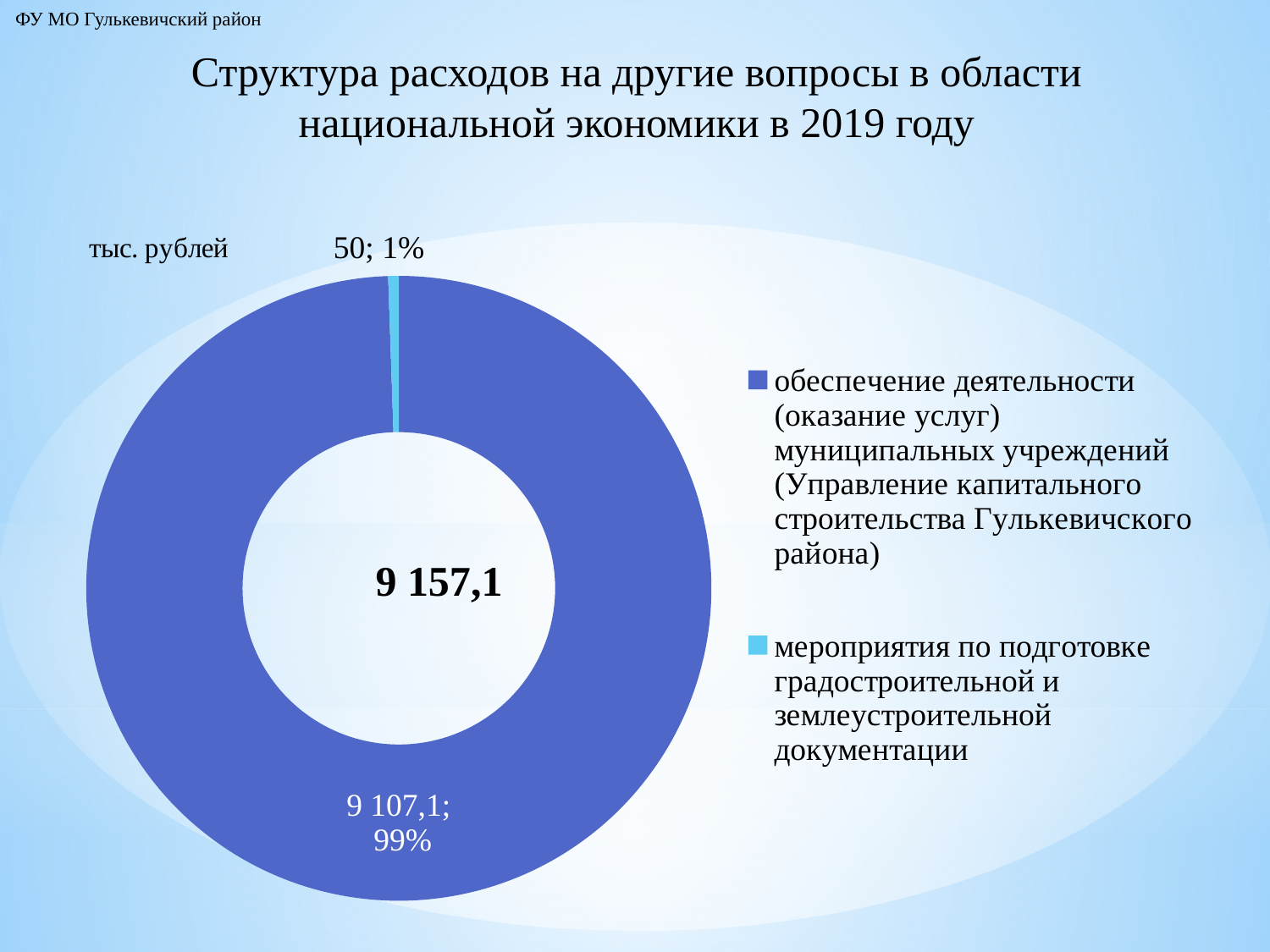
What colour is the slice for "мероприятия по подготовке градостроительной и землеустроительной документации"? light blue In what units are the chart values given? тыс. рублей What is the value for "мероприятия по подготовке градостроительной и землеустроительной документации"? 50 What is the difference between the values for "обеспечение деятельности" and "мероприятия по подготовке градостроительной и землеустроительной документации"? 9 057,1 What share of the chart does "обеспечение деятельности (оказание услуг) муниципальных учреждений" represent? 99% What total value is shown in the centre of the chart? 9 157,1 What type of chart is shown on the slide? doughnut (pie) chart Which category has the largest value? обеспечение деятельности (оказание услуг) муниципальных учреждений Which category has the smallest value? мероприятия по подготовке градостроительной и землеустроительной документации What is the value for "обеспечение деятельности (оказание услуг) муниципальных учреждений"? 9 107,1 How many categories does the chart show? 2 What share of the chart does "мероприятия по подготовке градостроительной и землеустроительной документации" represent? 1%